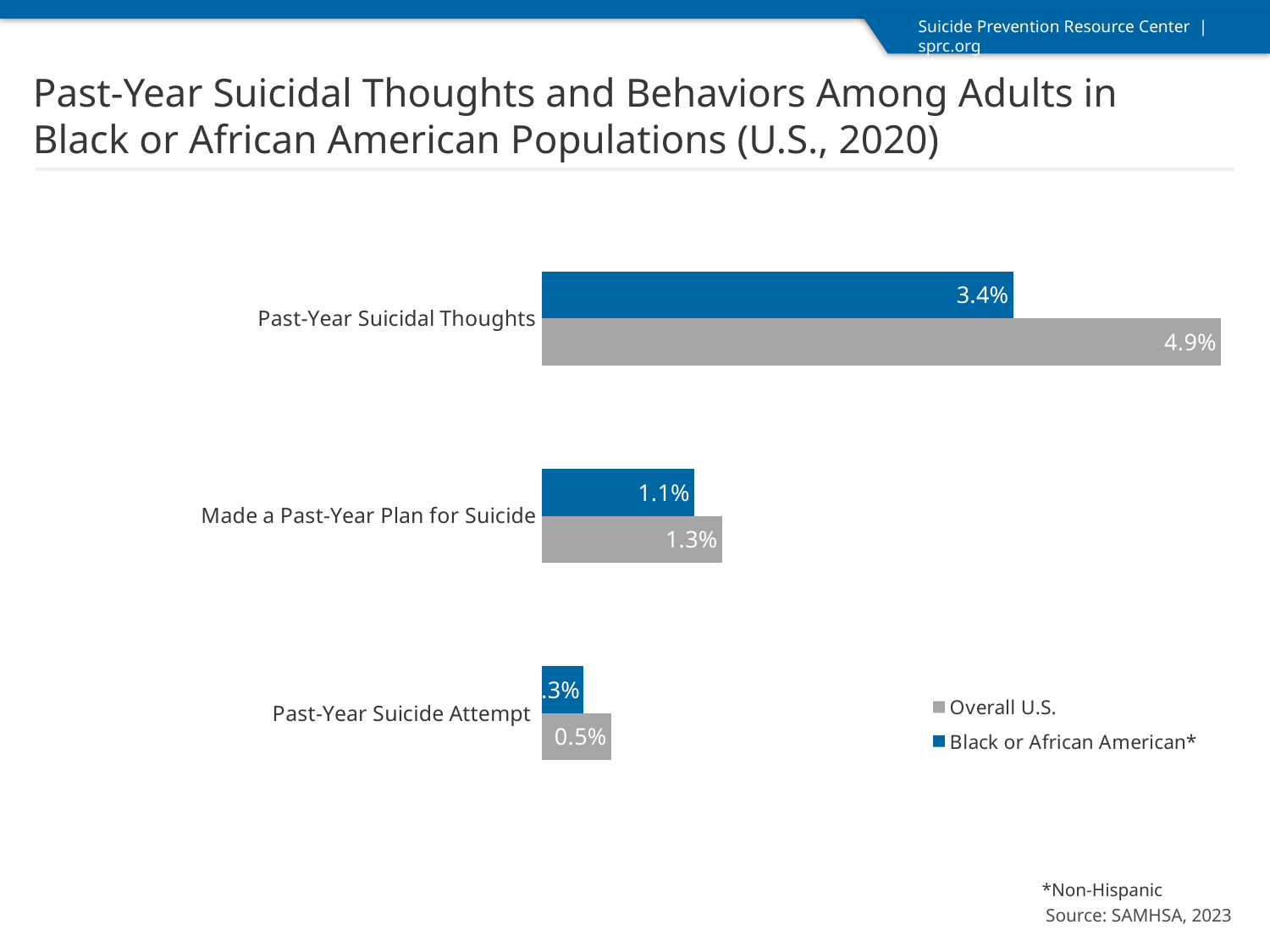
What is the Overall U.S. value for Past-Year Suicidal Thoughts? 4.9% For Made a Past-Year Plan for Suicide, which is larger: the Overall U.S. value or the Black or African American value? Overall U.S. How many categories are shown in the chart? 3 What is the value for Black or African American adults for Past-Year Suicidal Thoughts? 3.4% What is the Overall U.S. value for Past-Year Suicide Attempt? 0.5% What is the Overall U.S. value for Made a Past-Year Plan for Suicide? 1.3% What is the difference between the Overall U.S. and Black or African American values for Past-Year Suicidal Thoughts? 1.5 percentage points Which category has the lowest value for Black or African American adults? Past-Year Suicide Attempt What kind of chart is shown on the slide? Bar chart What is the value for Black or African American adults for Made a Past-Year Plan for Suicide? 1.1% How many series does the legend list? 2 Which category has the highest Overall U.S. value? Past-Year Suicidal Thoughts